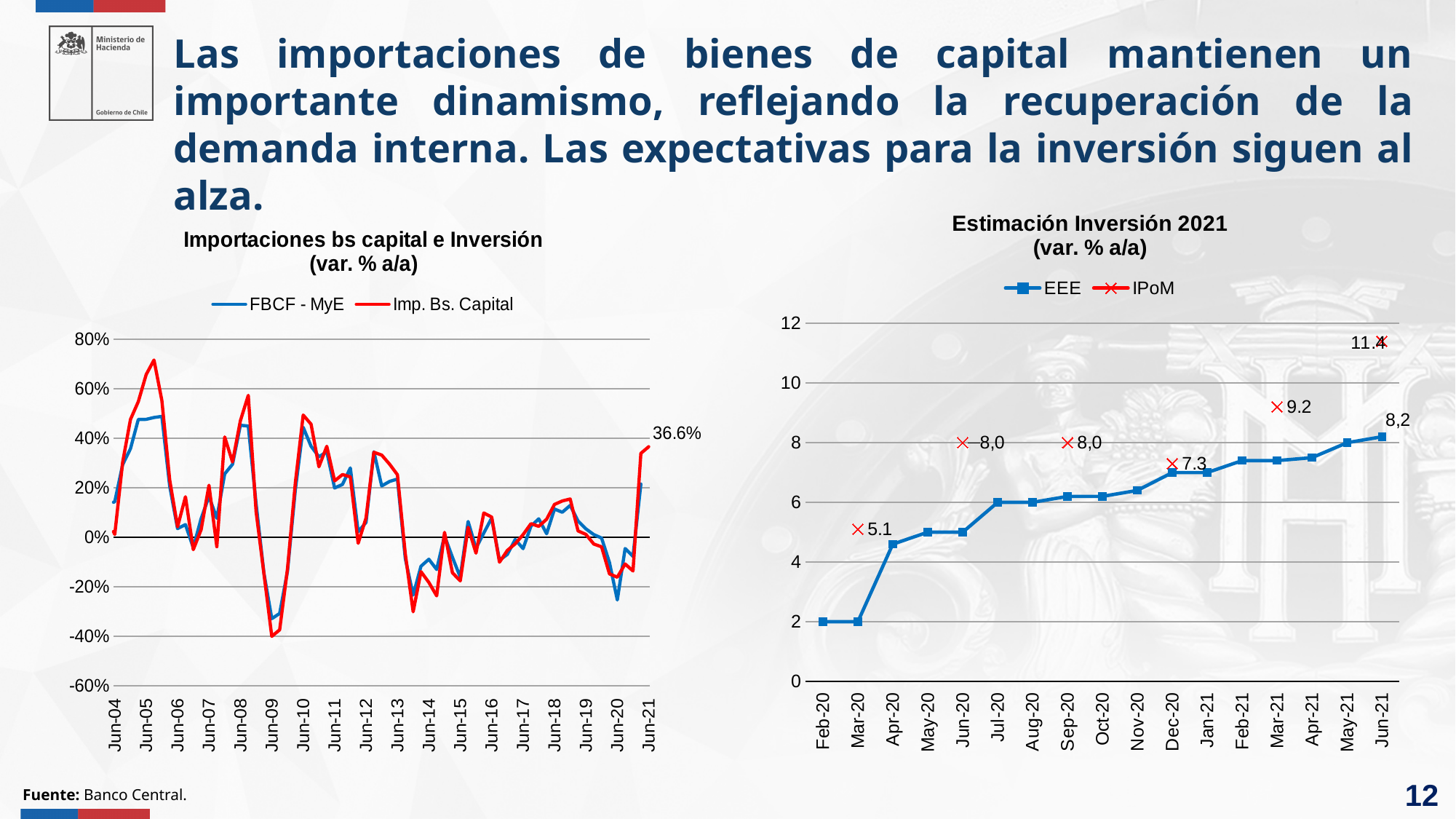
In the 'Estimación Inversión 2021' chart, in which month is the IPoM value lowest? Mar-20 In the 'Importaciones bs capital e Inversión' chart, what is the value of Imp. Bs. Capital for Jun-21? 36.6% In the 'Estimación Inversión 2021' chart, what is the difference between the IPoM values for Jun-21 and Mar-21? 2.2 How many series does the legend of the 'Estimación Inversión 2021' chart list? 2 In the 'Estimación Inversión 2021' chart, what is the IPoM value for Jun-21? 11.4 In the 'Estimación Inversión 2021' chart, is the EEE value for Apr-20 greater or less than 4? greater What kind of chart is the 'Estimación Inversión 2021' chart on the right? line chart In the 'Estimación Inversión 2021' chart, which series has the larger value in Jun-21, EEE or IPoM? IPoM In the 'Estimación Inversión 2021' chart, in which month is the IPoM value highest? Jun-21 In the 'Estimación Inversión 2021' chart, what is the EEE value for Jun-21? 8,2 In the 'Estimación Inversión 2021' chart, what is the IPoM value for Mar-20? 5.1 How many months are shown on the x axis of the 'Estimación Inversión 2021' chart? 17